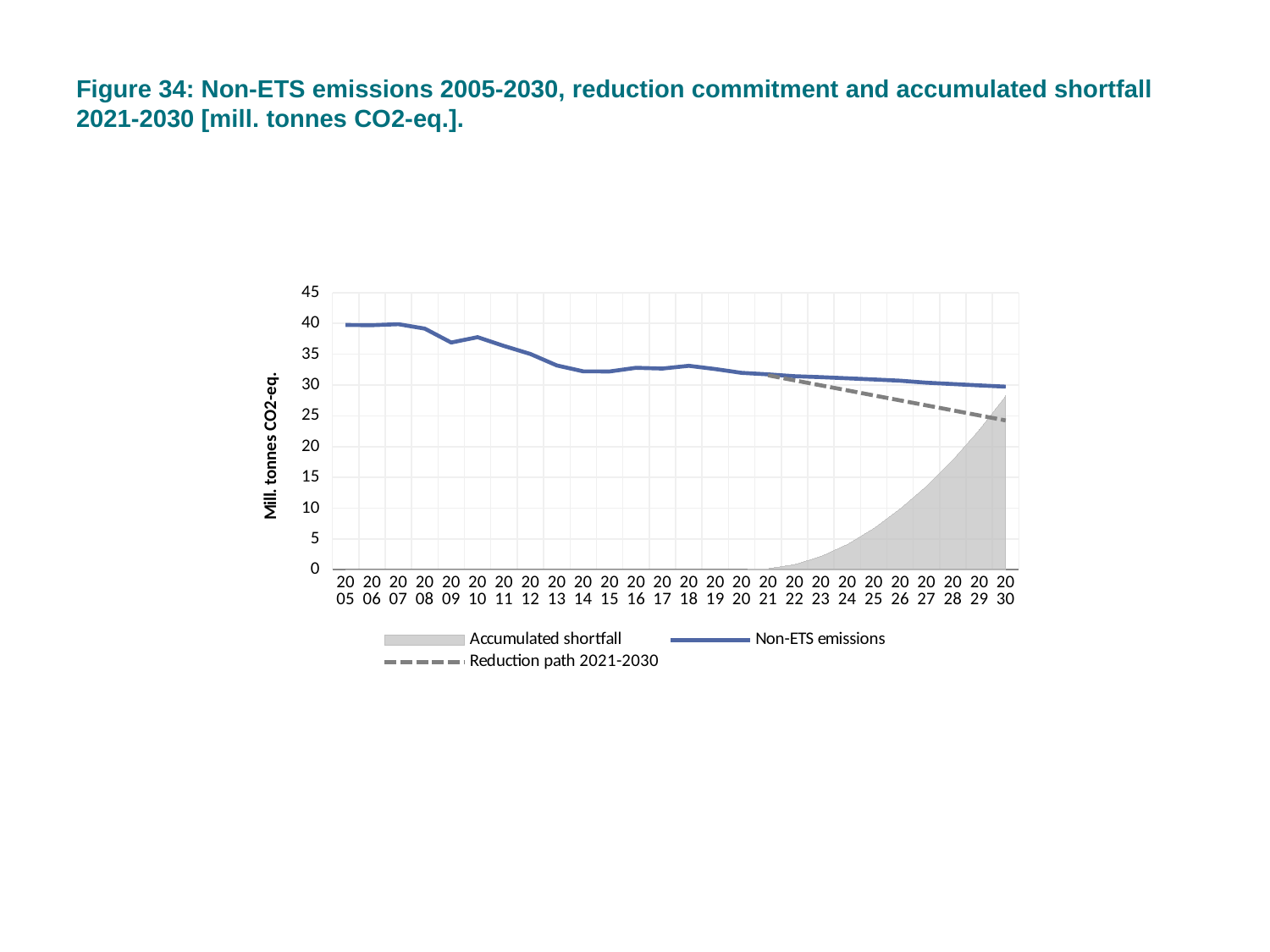
Do Non-ETS emissions rise or fall overall from 2005 to 2030? fall Is the value for the Reduction path 2021-2030 in 2030 greater or less than 30? less How many years are shown along the x axis? 26 How many series does the legend list? 3 Is the value for Non-ETS emissions in 2030 greater or less than 35? less Is the value for Non-ETS emissions in 2005 greater or less than 35? greater Which is larger in 2030: Non-ETS emissions or the Reduction path 2021-2030? Non-ETS emissions What is the label on the y axis? Mill. tonnes CO2-eq. What kind of chart is shown on the slide? combination area and line chart Does the Accumulated shortfall rise or fall from 2021 to 2030? rise